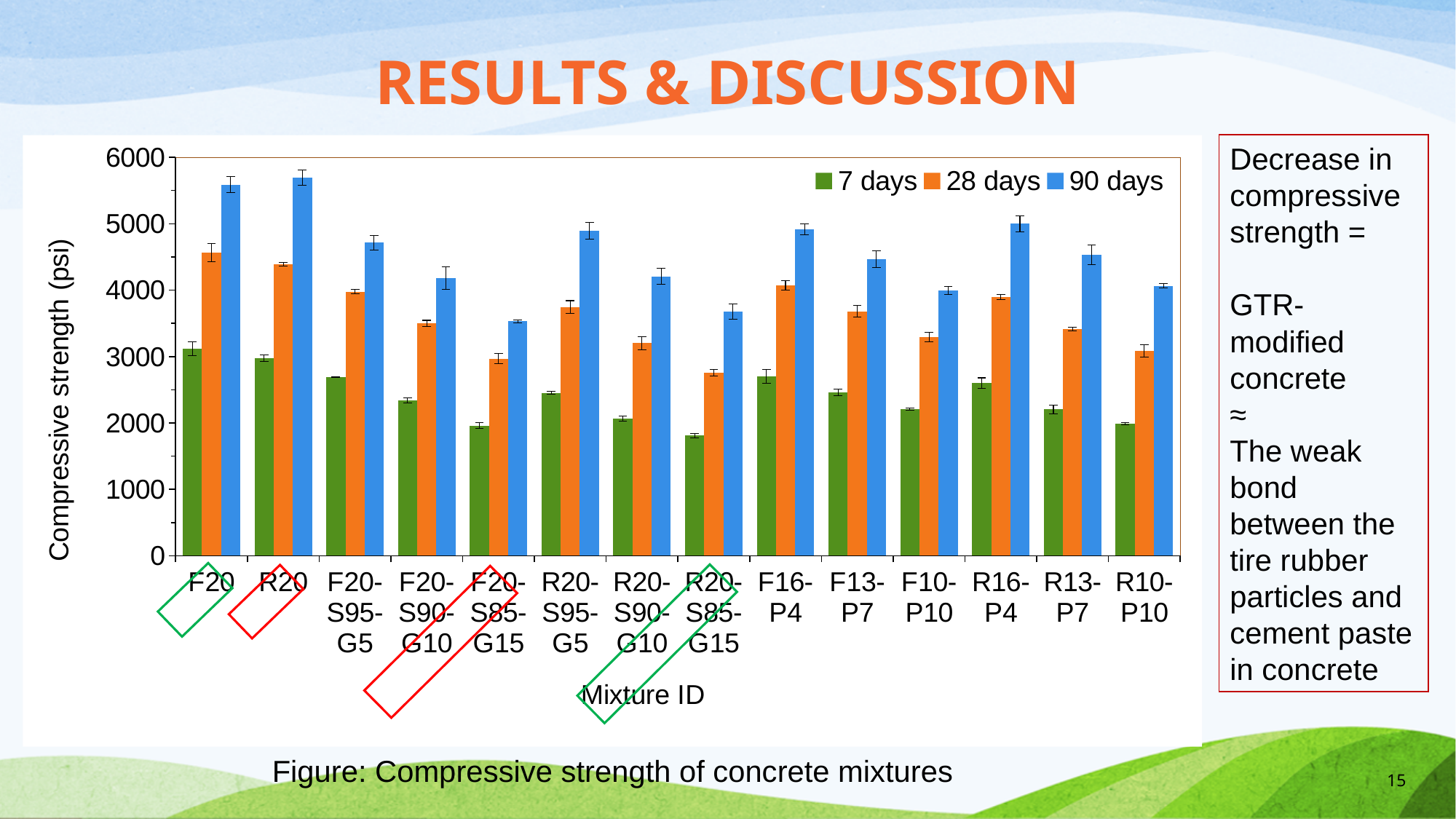
What kind of chart is shown on the slide? bar chart Is the 7 days value for R20-S85-G15 greater or less than 2000? less What is the label of the y axis? Compressive strength (psi) How many mixture IDs are shown on the x axis? 14 Is the 90 days value for F20 greater or less than 5000? greater How many series does the legend list? 3 Which mixture has the lowest 7 days compressive strength? R20-S85-G15 Is the 28 days value for F10-P10 greater or less than 3000? greater Which series is shown in blue? 90 days Which is larger, the 28 days value for F20 or the 28 days value for R20? F20 Which is larger, the 28 days value for F13-P7 or the 28 days value for R13-P7? F13-P7 Which mixture has the highest 28 days compressive strength? F20